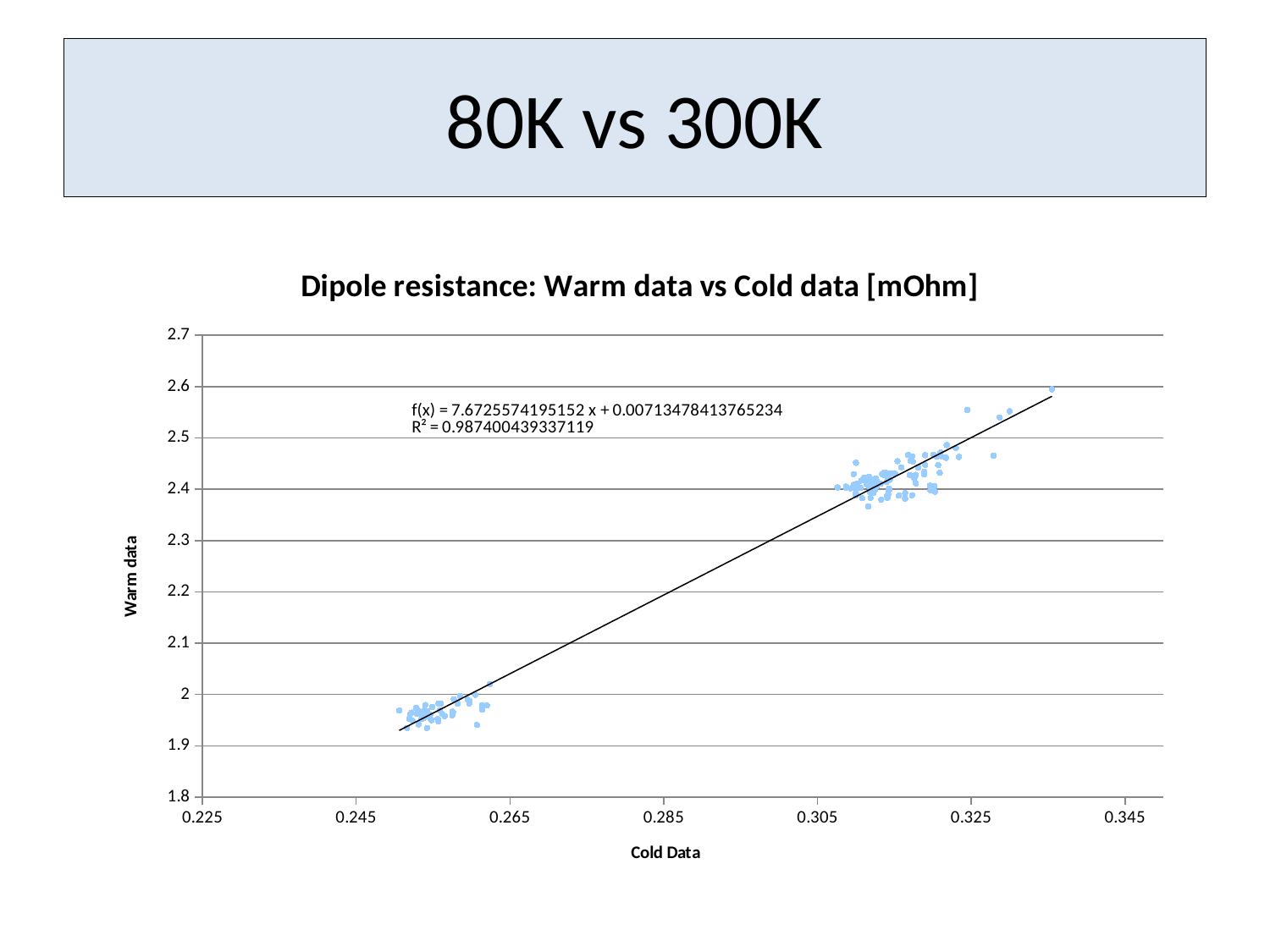
Which group of points has higher Warm data values: those with Cold Data around 0.255 or those with Cold Data around 0.315? Those with Cold Data around 0.315 What is the slope of the fitted line f(x) printed on the chart? 7.6725574195152 What R² value is printed on the chart for the fitted line? 0.987400439337119 What is the label of the horizontal axis of the chart? Cold Data What is the title of the chart? Dipole resistance: Warm data vs Cold data [mOhm] Are the Warm data values for the points with Cold Data around 0.315 greater or less than 2.3? greater Are the Warm data values for the points with Cold Data around 0.255 greater or less than 2.1? less What is the intercept of the fitted line f(x) printed on the chart? 0.00713478413765234 How many distinct clusters of data points does the scatter chart show? 2 What kind of chart is shown on the slide? Scatter chart Is the Warm data value of the highest point (Cold Data around 0.336) greater or less than 2.5? greater As Cold Data increases along the x axis, do the Warm data values rise or fall? Rise